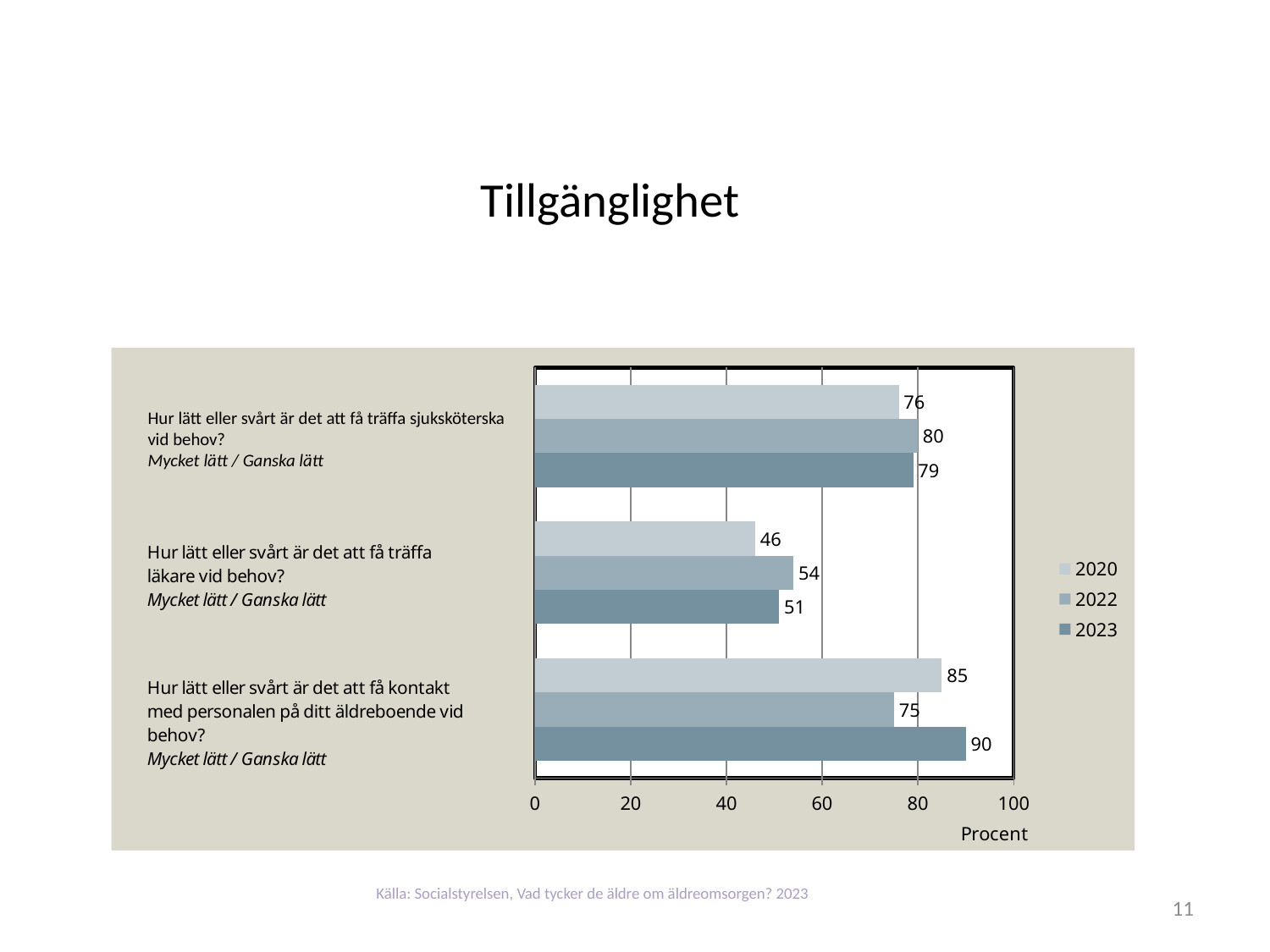
What is the 2020 value for "Hur lätt eller svårt är det att få kontakt med personalen på ditt äldreboende vid behov?" 85 What is the label of the horizontal axis? Procent Which category has the highest 2023 value? Hur lätt eller svårt är det att få kontakt med personalen på ditt äldreboende vid behov? How many categories (questions) are shown in the chart? 3 Is the 2022 value for "Hur lätt eller svårt är det att få träffa läkare vid behov?" greater or less than 60? less How many series does the legend list? 3 For "Hur lätt eller svårt är det att få träffa läkare vid behov?", which year has the larger value, 2020 or 2022? 2022 What is the 2022 value for "Hur lätt eller svårt är det att få träffa sjuksköterska vid behov?" 80 What kind of chart is shown on the slide? bar chart Which category has the lowest 2020 value? Hur lätt eller svårt är det att få träffa läkare vid behov? What is the 2023 value for "Hur lätt eller svårt är det att få träffa läkare vid behov?" 51 What is the difference between the 2023 and 2022 values for "Hur lätt eller svårt är det att få kontakt med personalen på ditt äldreboende vid behov?" 15